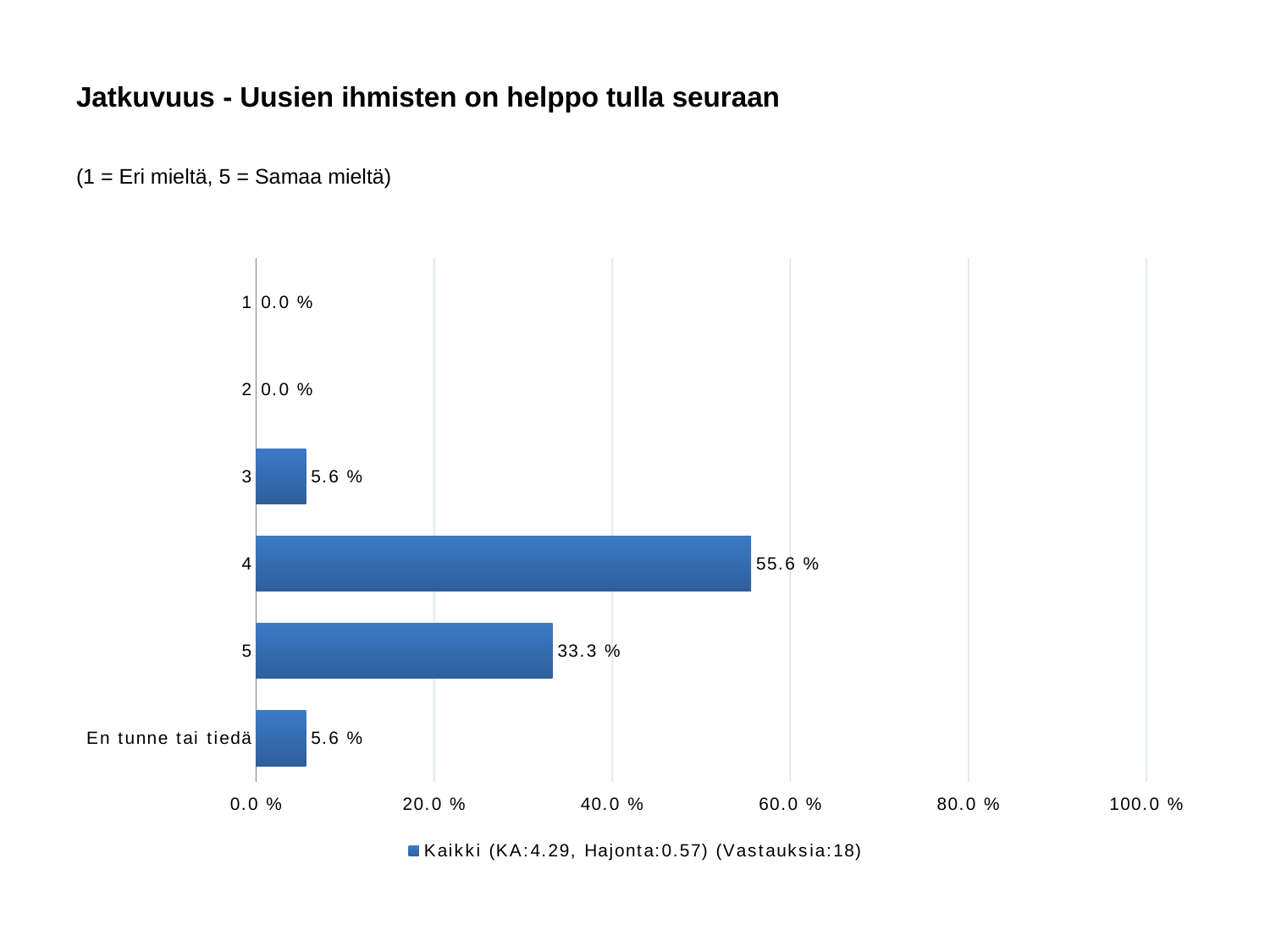
What is the value for category 3? 5.6 % What kind of chart is shown on the slide? bar chart How many series does the legend list? 1 Which category has the highest value? 4 Is the value for category 4 greater or less than 40.0 %? greater What is the value for category 5? 33.3 % What is the difference between the values for category 4 and category 5? 22.3 % How many categories are shown on the chart? 6 What is the title of the chart? Jatkuvuus - Uusien ihmisten on helppo tulla seuraan What is the value for category 4? 55.6 % Which is larger, the value for category 5 or the value for category 3? 5 What is the value for 'En tunne tai tiedä'? 5.6 %